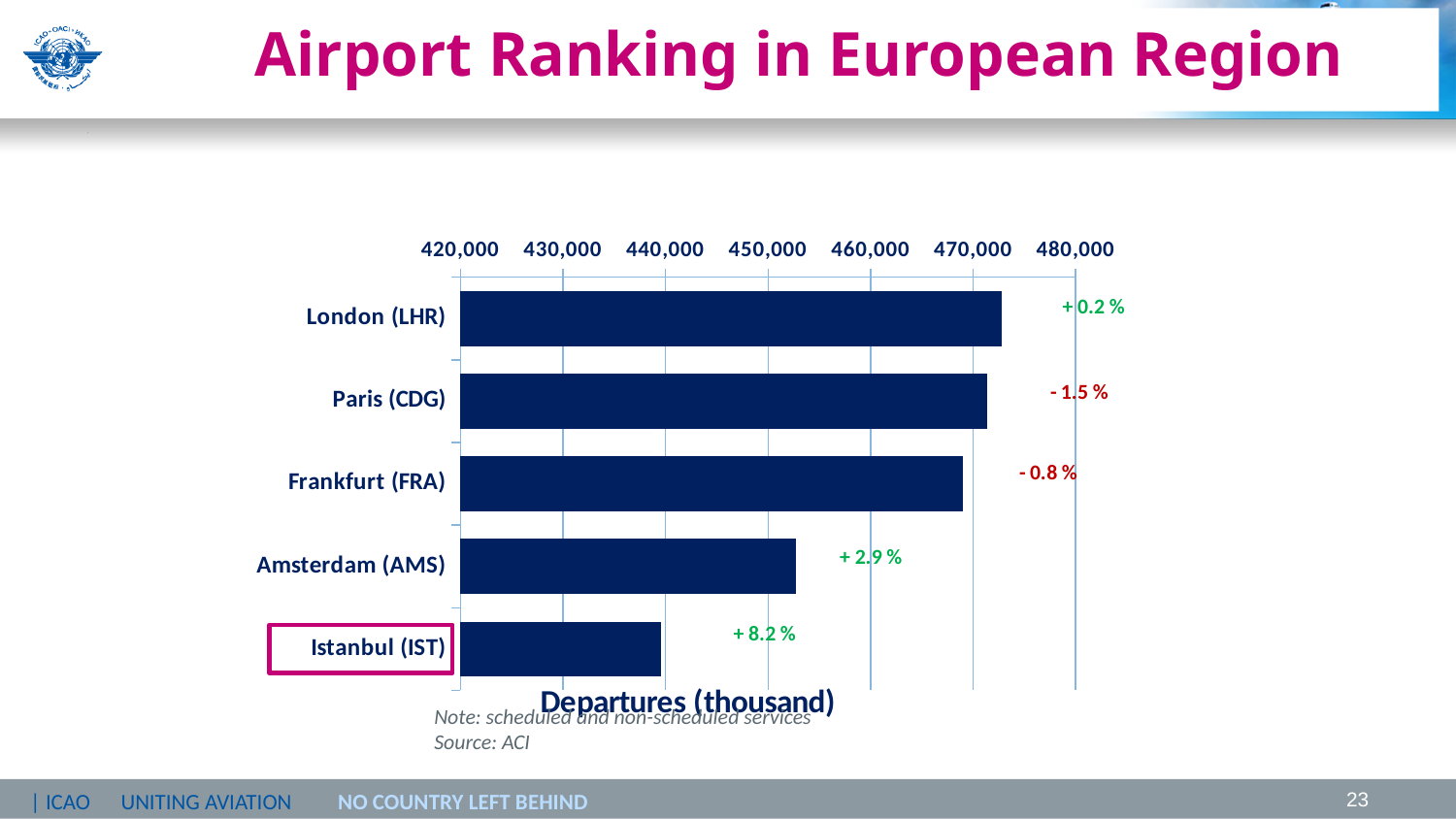
Is the value for London (LHR) greater or less than 470,000? greater Is the value for Frankfurt (FRA) greater or less than 470,000? less Which airport has the lowest number of departures in the chart? Istanbul (IST) What percentage change is shown next to the Paris (CDG) bar? - 1.5 % Which has more departures, Frankfurt (FRA) or Amsterdam (AMS)? Frankfurt (FRA) What is the title of the horizontal axis of the chart? Departures (thousand) What percentage change is shown next to the Istanbul (IST) bar? + 8.2 % What kind of chart is shown on the slide? bar chart Which airport shows the largest percentage increase in the chart? Istanbul (IST) How many airports are shown in the chart? 5 What percentage change is shown next to the Amsterdam (AMS) bar? + 2.9 % Is the value for Amsterdam (AMS) greater or less than 460,000? less